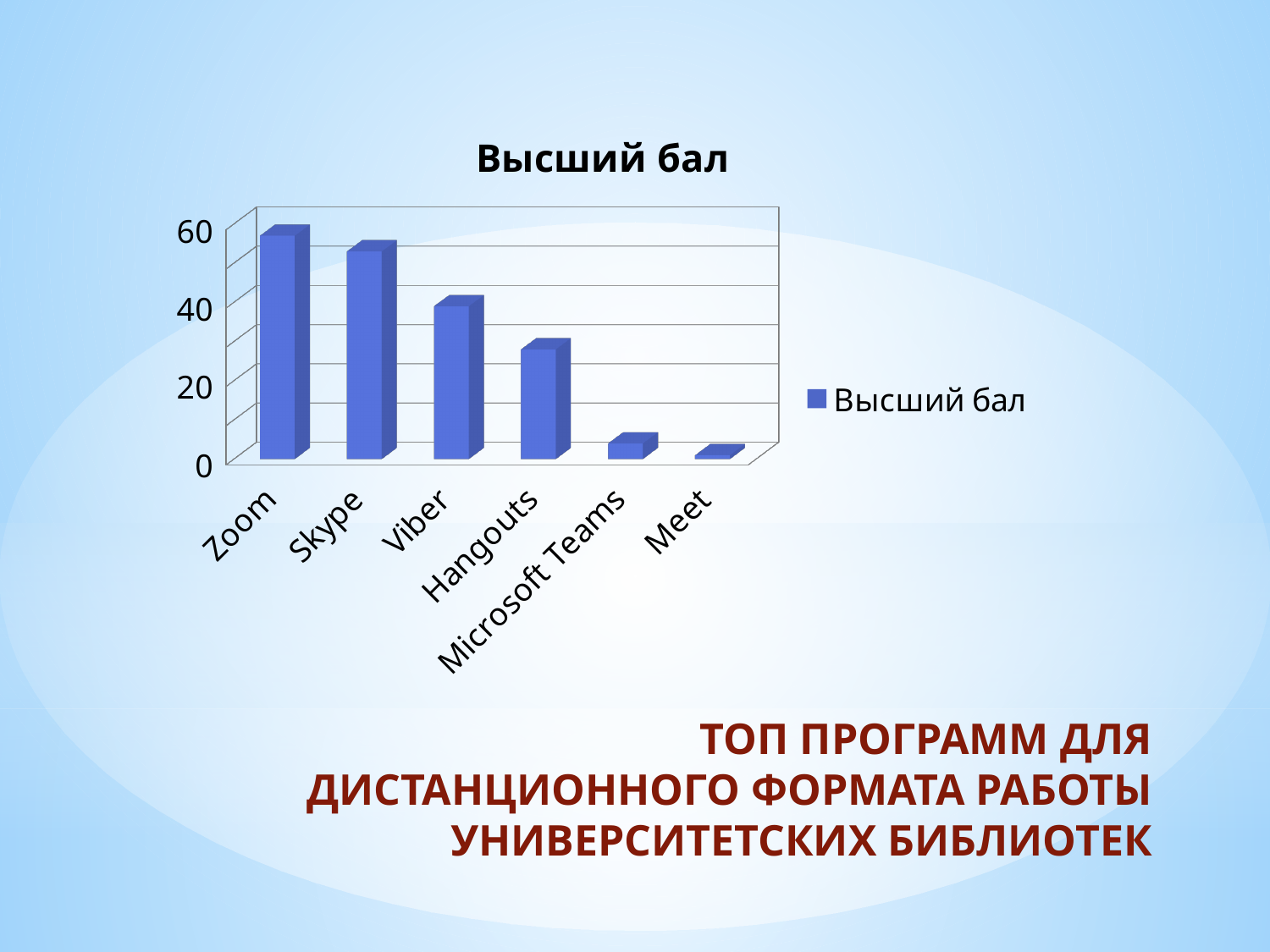
Which has a larger value, Microsoft Teams or Skype? Skype Is the value for Hangouts greater or less than 40? less Which category has the highest value? Zoom Do the values rise or fall from left to right along the x axis? fall What is the title of the chart? Высший бал Which category has the lowest value? Meet What kind of chart is shown on the slide? bar chart Which has a larger value, Viber or Hangouts? Viber Is the value for Microsoft Teams greater or less than 20? less How many categories are shown on the x axis of the chart? 6 How many series does the legend list? 1 Is the value for Zoom greater or less than 40? greater